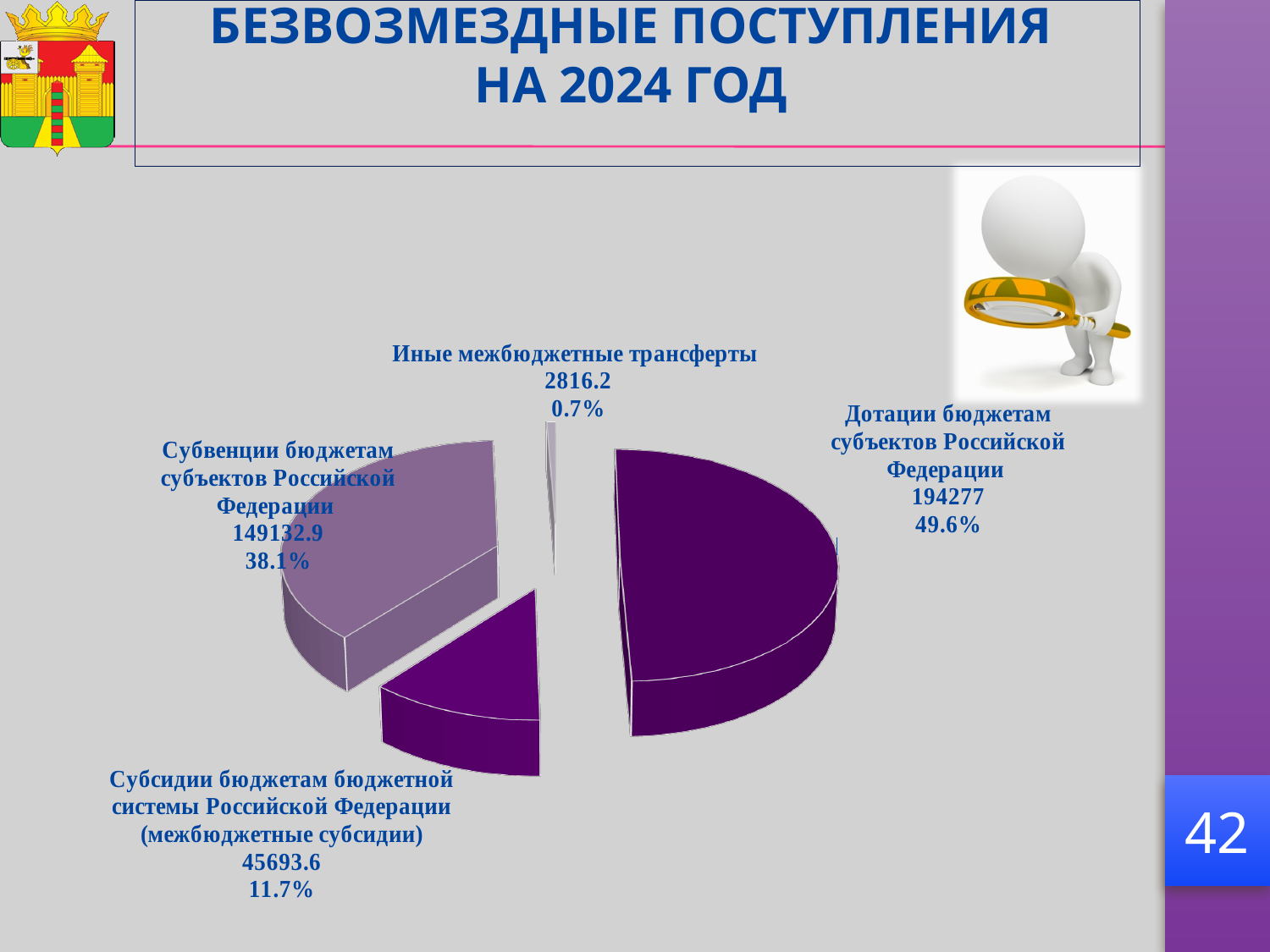
What kind of chart is shown on the slide? Pie chart What is the value for Субвенции бюджетам субъектов Российской Федерации? 149132.9 What is the value for Дотации бюджетам субъектов Российской Федерации? 194277 How many slices does the pie chart have? 4 What share of the pie does Субвенции бюджетам субъектов Российской Федерации represent? 38.1% What is the value for Субсидии бюджетам бюджетной системы Российской Федерации (межбюджетные субсидии)? 45693.6 Which category has the largest slice of the pie? Дотации бюджетам субъектов Российской Федерации What share of the pie does Дотации бюджетам субъектов Российской Федерации represent? 49.6% What is the value for Иные межбюджетные трансферты? 2816.2 Which category has the smallest slice of the pie? Иные межбюджетные трансферты Which is larger: the value for Субсидии бюджетам бюджетной системы Российской Федерации (межбюджетные субсидии) or the value for Иные межбюджетные трансферты? Субсидии бюджетам бюджетной системы Российской Федерации (межбюджетные субсидии) What is the title of the slide containing the chart? БЕЗВОЗМЕЗДНЫЕ ПОСТУПЛЕНИЯ НА 2024 ГОД